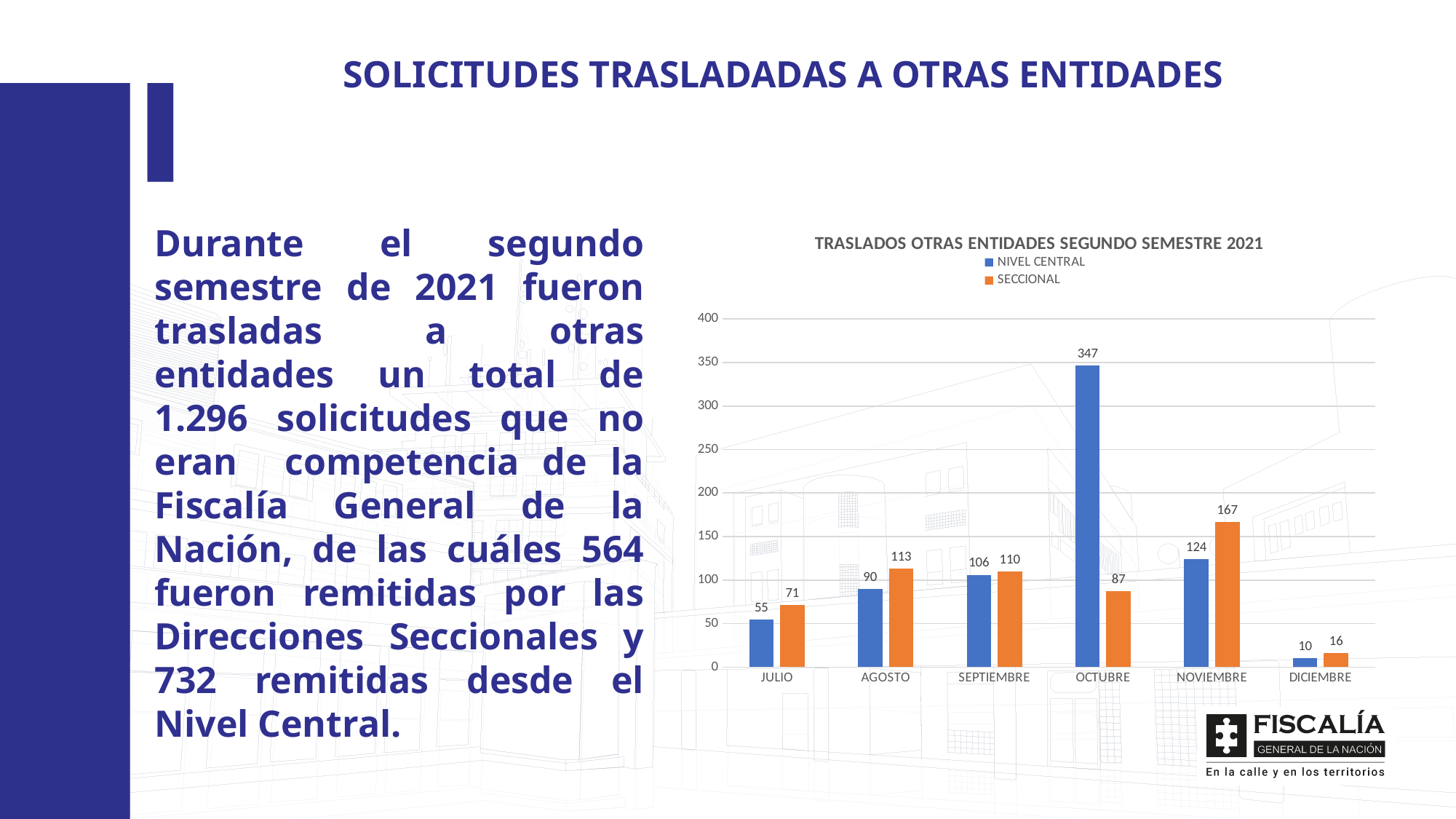
What is the SECCIONAL value for NOVIEMBRE? 167 What is the difference between the NIVEL CENTRAL and SECCIONAL values for OCTUBRE? 260 What is the SECCIONAL value for JULIO? 71 What is the title of the chart? TRASLADOS OTRAS ENTIDADES SEGUNDO SEMESTRE 2021 What is the NIVEL CENTRAL value for OCTUBRE? 347 What kind of chart is shown on the slide? bar chart Which is larger in AGOSTO, NIVEL CENTRAL or SECCIONAL? SECCIONAL Which month has the lowest SECCIONAL value? DICIEMBRE Which month has the highest NIVEL CENTRAL value? OCTUBRE How many months are shown on the x axis? 6 How many series does the legend list? 2 Is the NIVEL CENTRAL value for OCTUBRE greater or less than 300? greater